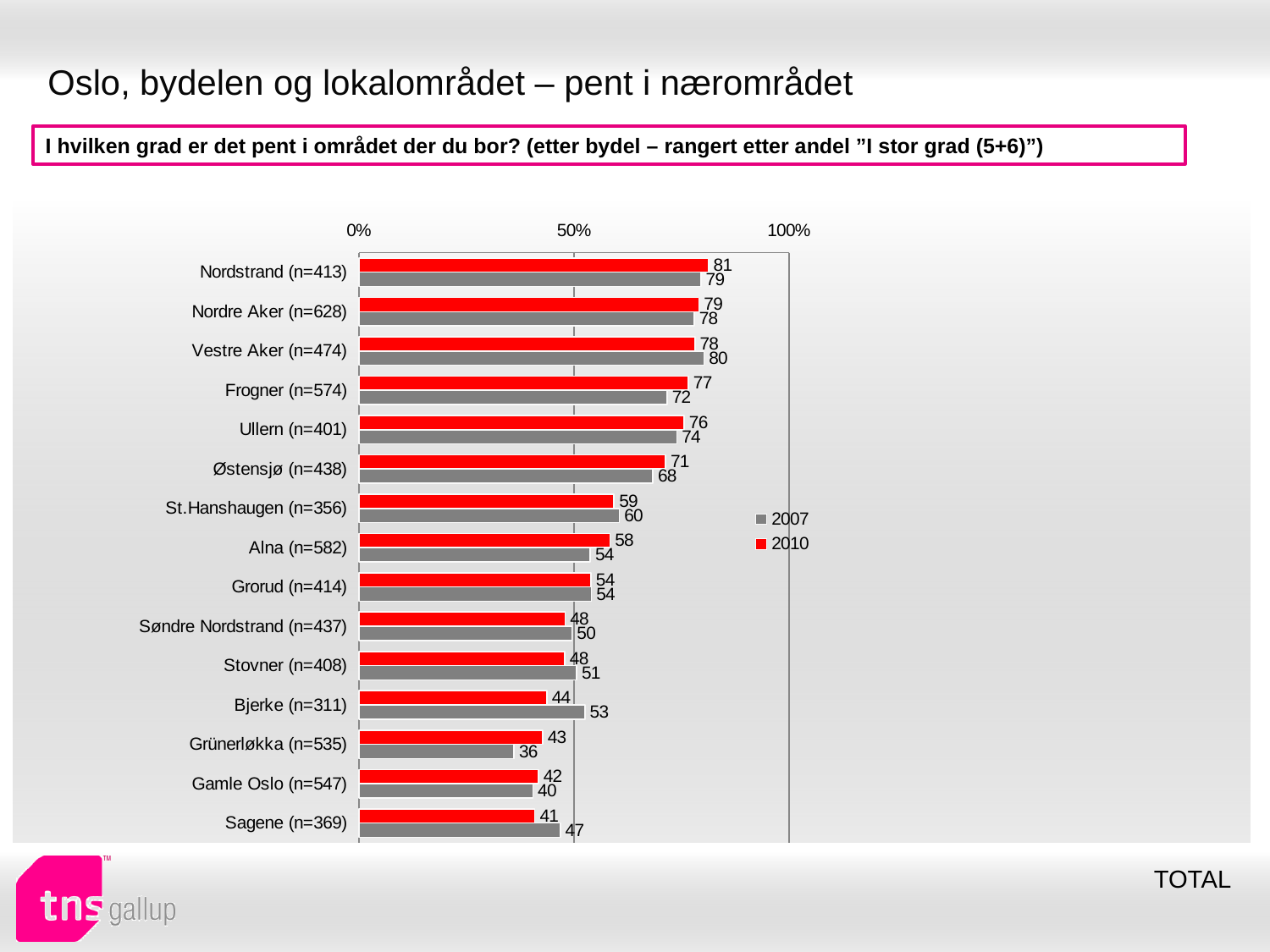
Which is larger for Vestre Aker (n=474): the 2007 value or the 2010 value? 2007 What is the 2010 value for Nordstrand (n=413)? 81 Is the 2007 value for Frogner (n=574) greater or less than 50%? greater How many series does the legend list? 2 Which colour represents the 2010 series? red What is the 2007 value for Bjerke (n=311)? 53 How many districts are shown in the chart? 15 Which district has the highest 2010 value? Nordstrand (n=413) Which district has the lowest 2010 value? Sagene (n=369) What is the difference between the 2010 and 2007 values for Bjerke (n=311)? 9 What kind of chart is shown on the slide? bar chart What is the 2007 value for Grünerløkka (n=535)? 36